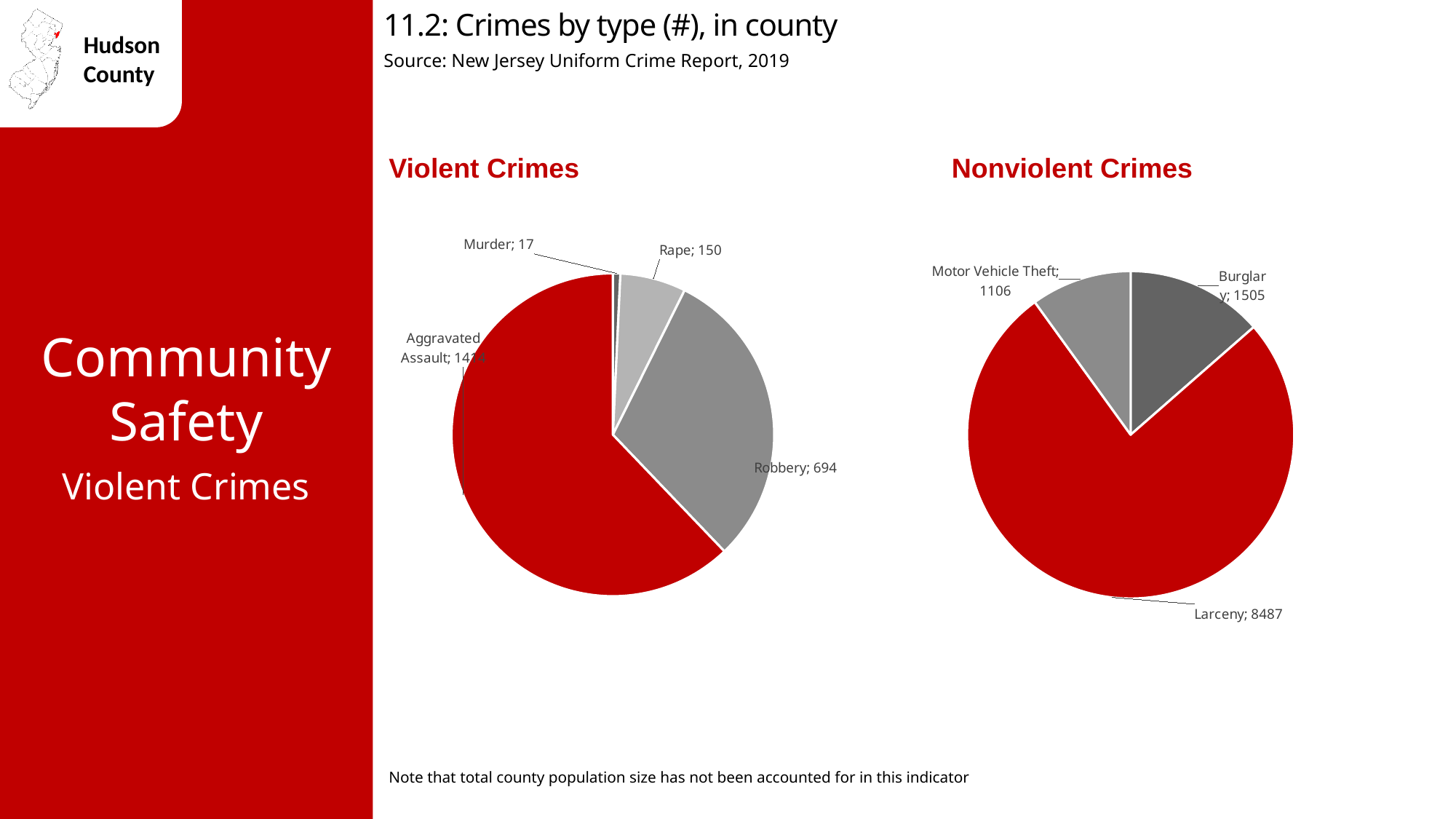
On the Nonviolent Crimes chart, what is the value for Burglary? 1505 On the Violent Crimes chart, what is the value for Rape? 150 On the Nonviolent Crimes chart, what is the difference between Burglary and Motor Vehicle Theft? 399 How many slices does the Nonviolent Crimes pie chart have? 3 On the Nonviolent Crimes chart, what is the value for Motor Vehicle Theft? 1106 On the Violent Crimes chart, which is larger, Robbery or Rape? Robbery On the Violent Crimes chart, what is the value for Murder? 17 On the Violent Crimes chart, which crime type has the largest slice? Aggravated Assault On the Nonviolent Crimes chart, which crime type has the smallest slice? Motor Vehicle Theft On the Violent Crimes chart, which crime type has the smallest slice? Murder On the Violent Crimes chart, how many robberies are shown? 694 On the Nonviolent Crimes chart, what is the value for Larceny? 8487